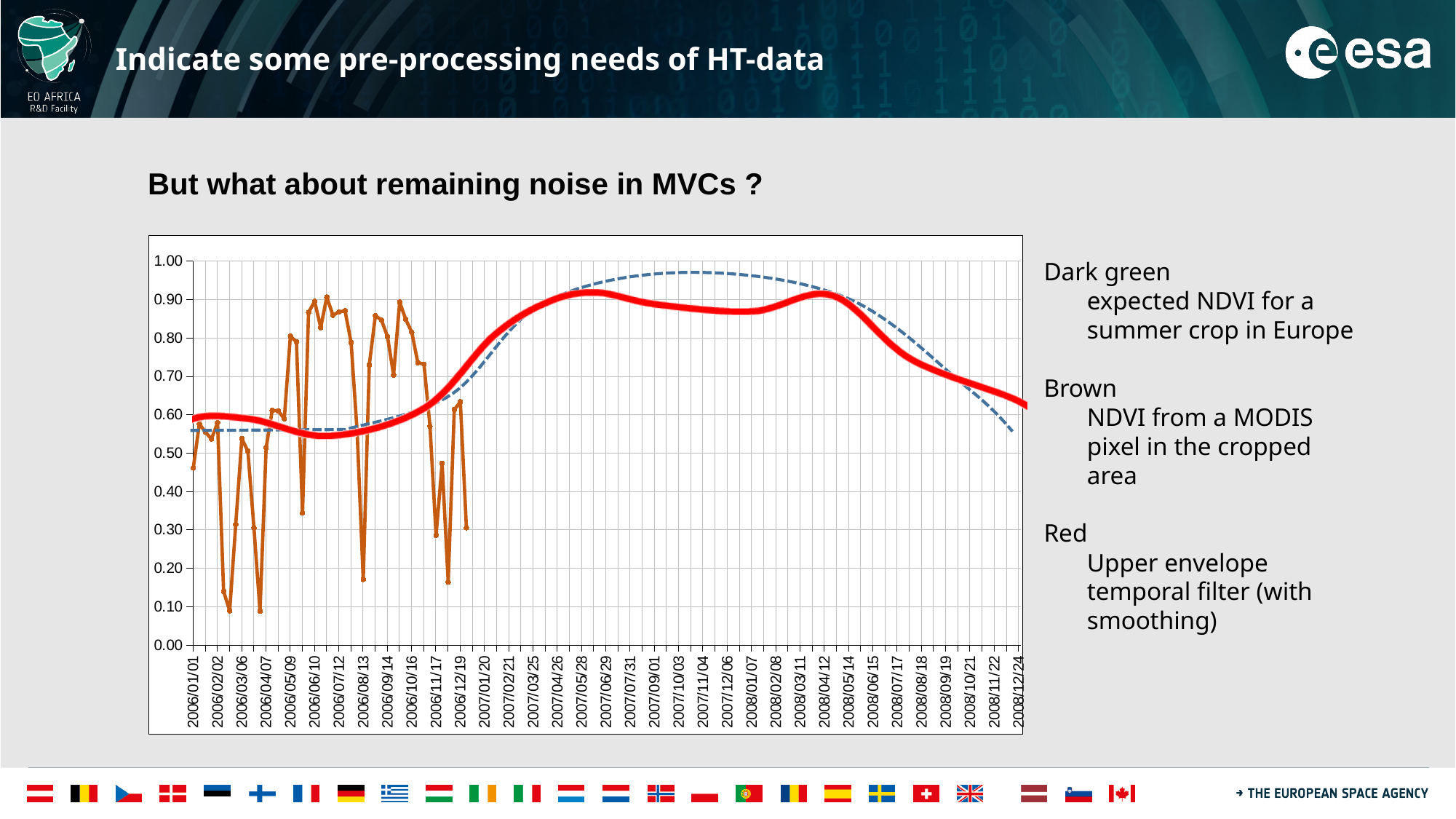
Does the red upper envelope line rise or fall between 2008/05/14 and 2008/12/24? fall Is the peak of the dashed expected NDVI curve around 2007/10/03 greater or less than 0.90? greater Is the value of the brown MODIS NDVI line at 2006/06/10 greater or less than 0.80? greater What is the first date label on the horizontal axis of the chart? 2006/01/01 Is the value of the dashed expected NDVI curve at 2008/12/24 greater or less than 0.60? less What is the highest value shown on the vertical axis of the chart? 1.00 According to the text beside the chart, which colour represents the upper envelope temporal filter? Red What is the last date label on the horizontal axis of the chart? 2008/12/24 What kind of chart is shown on the slide? line chart Does the red upper envelope line rise or fall between 2007/01/20 and 2007/05/28? rise